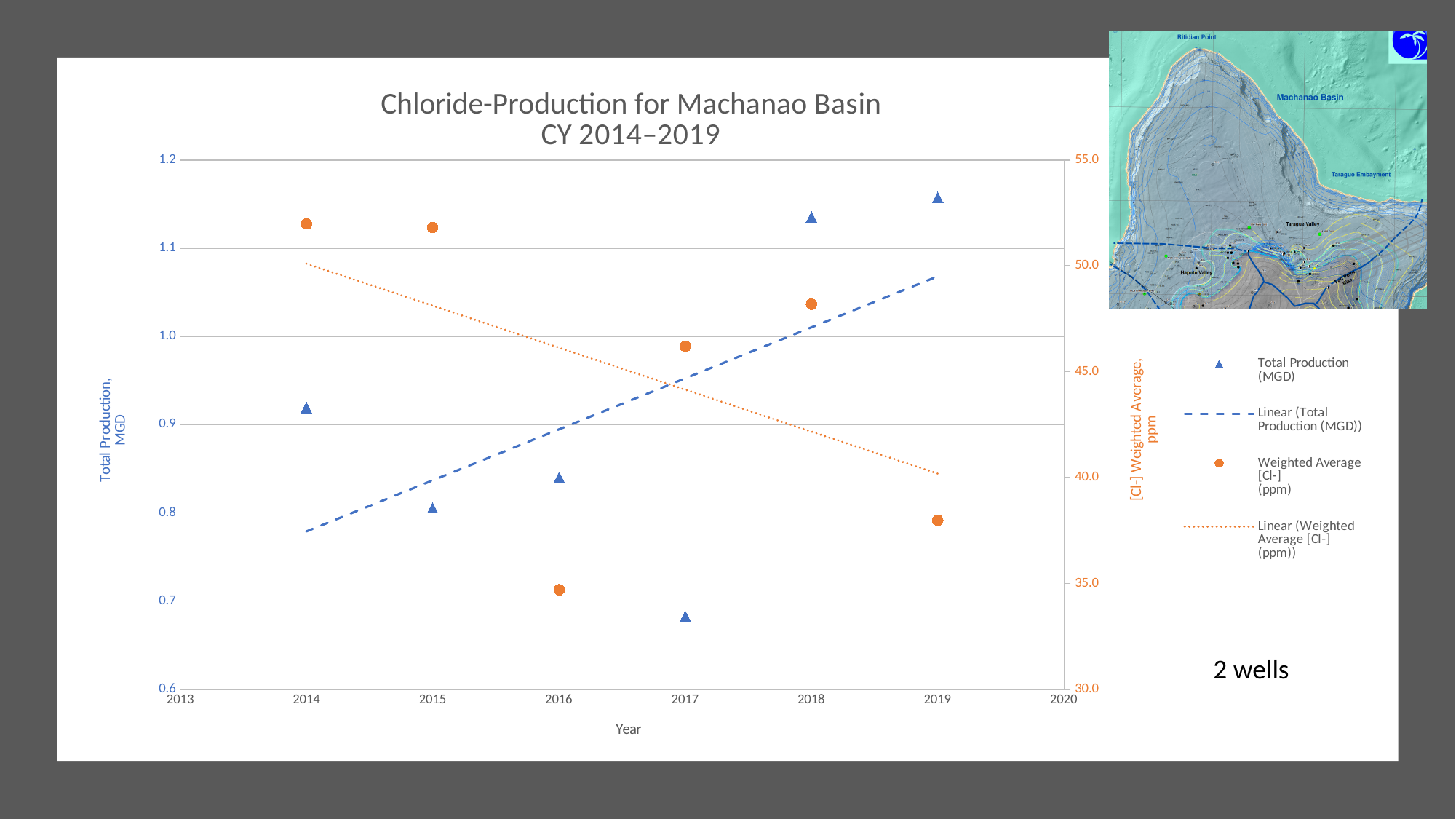
How many years of Total Production (MGD) data points are plotted? 6 Is the Total Production (MGD) for 2017 greater or less than 0.7? less Which year has the highest Total Production (MGD)? 2019 Is the Weighted Average [Cl-] (ppm) for 2014 greater or less than 50.0? greater What is the title of the chart? Chloride-Production for Machanao Basin CY 2014–2019 Is the Total Production (MGD) for 2018 greater or less than 1.1? greater Which year has the lowest Total Production (MGD)? 2017 What kind of chart is shown on the slide? scatter chart Does the linear trendline for Weighted Average [Cl-] (ppm) rise or fall from 2014 to 2019? fall How many entries does the chart legend list? 4 Which year has the lowest Weighted Average [Cl-] (ppm)? 2016